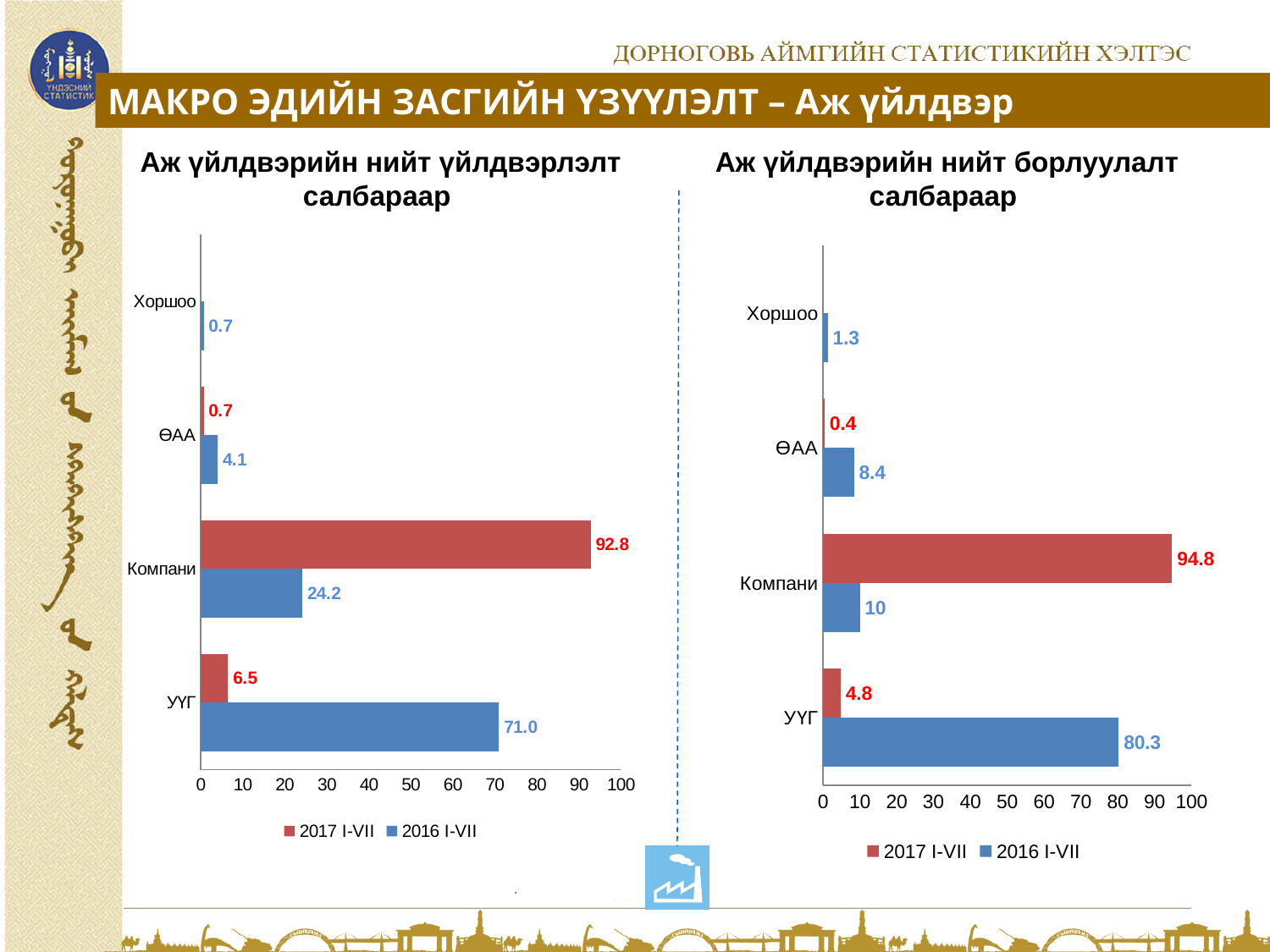
In the left chart (Аж үйлдвэрийн нийт үйлдвэрлэлт салбараар), what is the 2016 I-VII value for УҮГ? 71.0 In the right chart (Аж үйлдвэрийн нийт борлуулалт салбараар), what is the difference between the 2016 I-VII and 2017 I-VII values for УҮГ? 75.5 In the right chart (Аж үйлдвэрийн нийт борлуулалт салбараар), which category has the highest 2017 I-VII value? Компани In the left chart (Аж үйлдвэрийн нийт үйлдвэрлэлт салбараар), what is the 2017 I-VII value for Компани? 92.8 In the right chart (Аж үйлдвэрийн нийт борлуулалт салбараар), what is the 2017 I-VII value for УҮГ? 4.8 In the left chart (Аж үйлдвэрийн нийт үйлдвэрлэлт салбараар), what is the difference between the 2017 I-VII and 2016 I-VII values for Компани? 68.6 In the left chart (Аж үйлдвэрийн нийт үйлдвэрлэлт салбараар), which category has the highest 2016 I-VII value? УҮГ In the right chart (Аж үйлдвэрийн нийт борлуулалт салбараар), which is larger for УҮГ: the 2017 I-VII value or the 2016 I-VII value? 2016 I-VII In the right chart (Аж үйлдвэрийн нийт борлуулалт салбараар), what is the 2016 I-VII value for ӨАА? 8.4 In the left chart (Аж үйлдвэрийн нийт үйлдвэрлэлт салбараар), how many series does the legend list? 2 How many categories are shown on the y axis of the right chart (Аж үйлдвэрийн нийт борлуулалт салбараар)? 4 What type of chart is the left chart (Аж үйлдвэрийн нийт үйлдвэрлэлт салбараар)? Bar chart